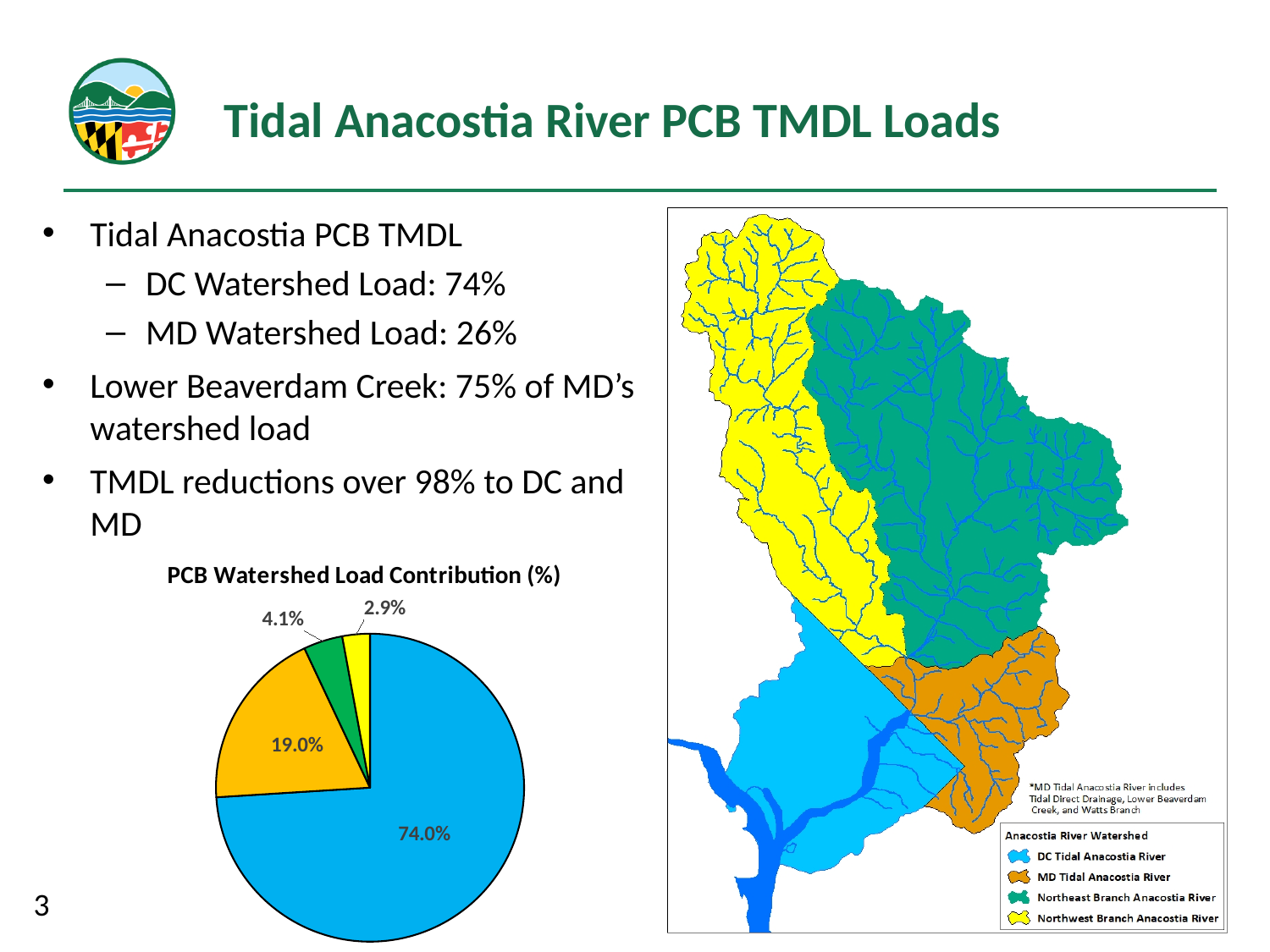
What value is labelled on the orange slice of the pie chart? 19.0% What is the title of the pie chart? PCB Watershed Load Contribution (%) Which slice is larger in the pie chart, the green slice or the yellow slice? the green slice What value is labelled on the yellow slice of the pie chart? 2.9% What kind of chart is shown on the slide? pie chart What is the difference between the largest slice (74.0%) and the second-largest slice (19.0%) in the pie chart? 55.0% What value is labelled on the green slice of the pie chart? 4.1% What is the value of the smallest slice in the pie chart? 2.9% What is the combined share of the two smallest slices (4.1% and 2.9%) in the pie chart? 7.0% What value is labelled on the blue slice of the pie chart? 74.0% What is the value of the largest slice in the pie chart? 74.0% How many slices does the pie chart have? 4